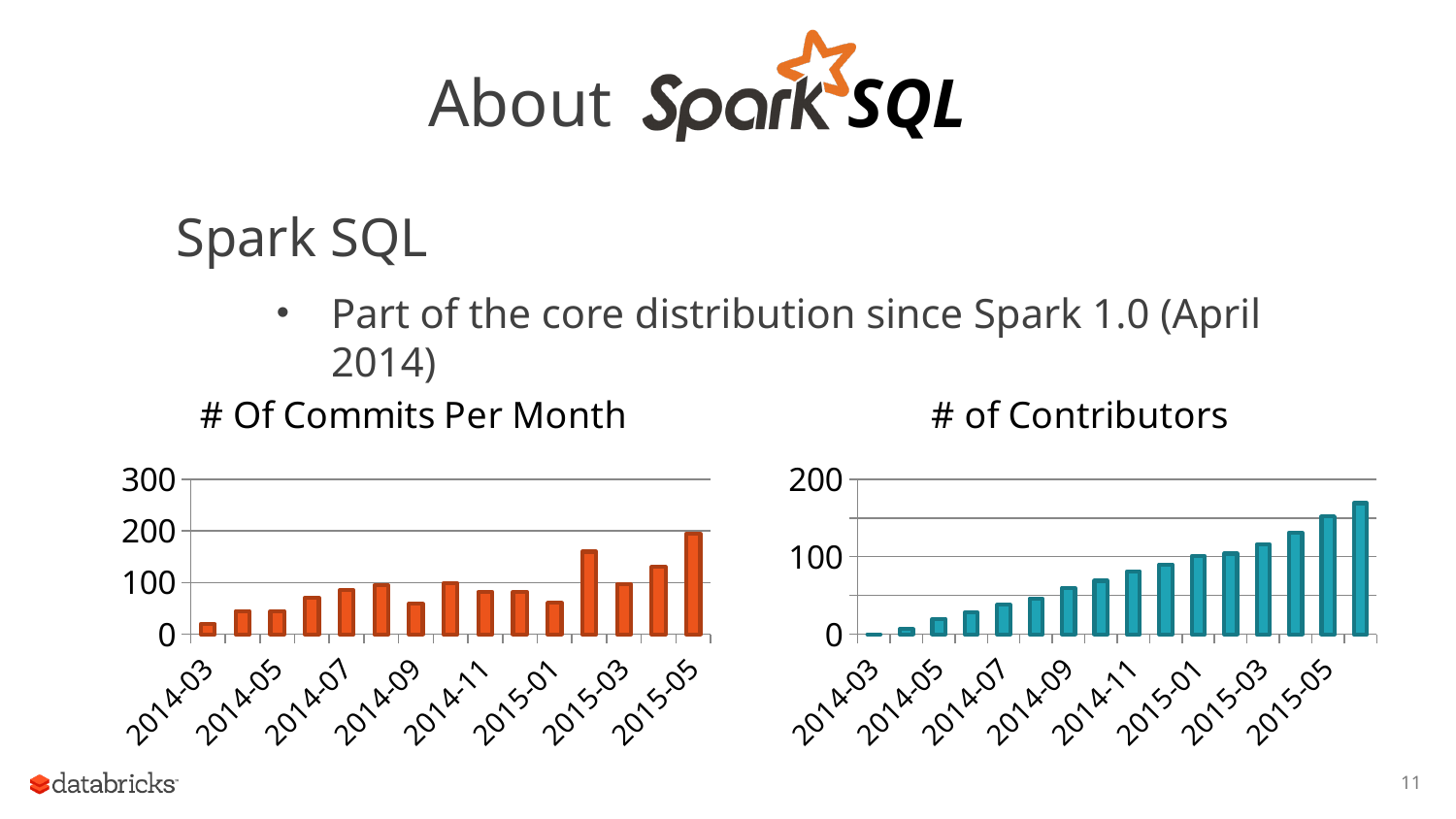
How many bars are plotted in the "# of Contributors" chart? 16 What kind of chart is the "# Of Commits Per Month" chart? bar chart In the "# Of Commits Per Month" chart, is the value for 2014-03 greater or less than 100? less In the "# of Contributors" chart, is the value for 2015-05 greater or less than 100? greater In the "# Of Commits Per Month" chart, which month has the highest number of commits? 2015-05 In the "# Of Commits Per Month" chart, which is larger, the value for 2015-05 or the value for 2015-03? 2015-05 In the "# of Contributors" chart, do the values rise or fall from 2014-03 to 2015-05? rise In the "# Of Commits Per Month" chart, is the value for 2015-05 greater or less than 100? greater In the "# of Contributors" chart, which month has the lowest number of contributors? 2014-03 In the "# Of Commits Per Month" chart, which month has the lowest number of commits? 2014-03